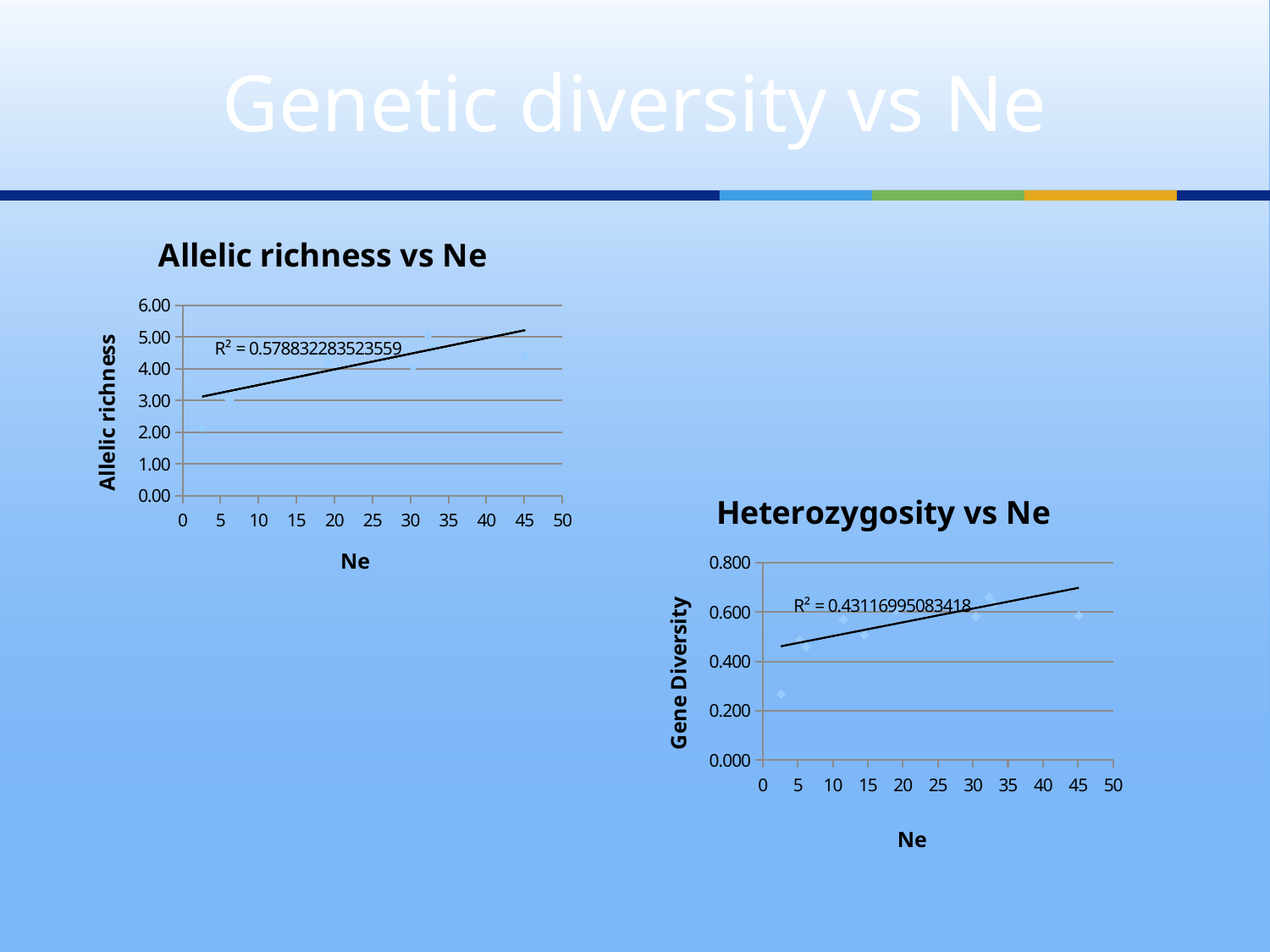
What is the y-axis title of the "Heterozygosity vs Ne" chart? Gene Diversity In the "Heterozygosity vs Ne" chart, does the trendline rise or fall as Ne increases? Rises In the "Allelic richness vs Ne" chart, what R² value is printed for the trendline? R² = 0.578832283523559 What kind of chart is the "Heterozygosity vs Ne" chart? Scatter chart Which chart has the higher R² value, "Allelic richness vs Ne" or "Heterozygosity vs Ne"? Allelic richness vs Ne What kind of chart is the "Allelic richness vs Ne" chart? Scatter chart In the "Heterozygosity vs Ne" chart, is the gene diversity of the point with the smallest Ne greater or less than 0.400? less In the "Heterozygosity vs Ne" chart, what R² value is printed for the trendline? R² = 0.431169950834418 How many charts are shown on the slide? 2 In the "Allelic richness vs Ne" chart, what is the maximum value shown on the y-axis? 6.00 What is the x-axis title of the "Allelic richness vs Ne" chart? Ne In the "Allelic richness vs Ne" chart, does the trendline rise or fall as Ne increases? Rises